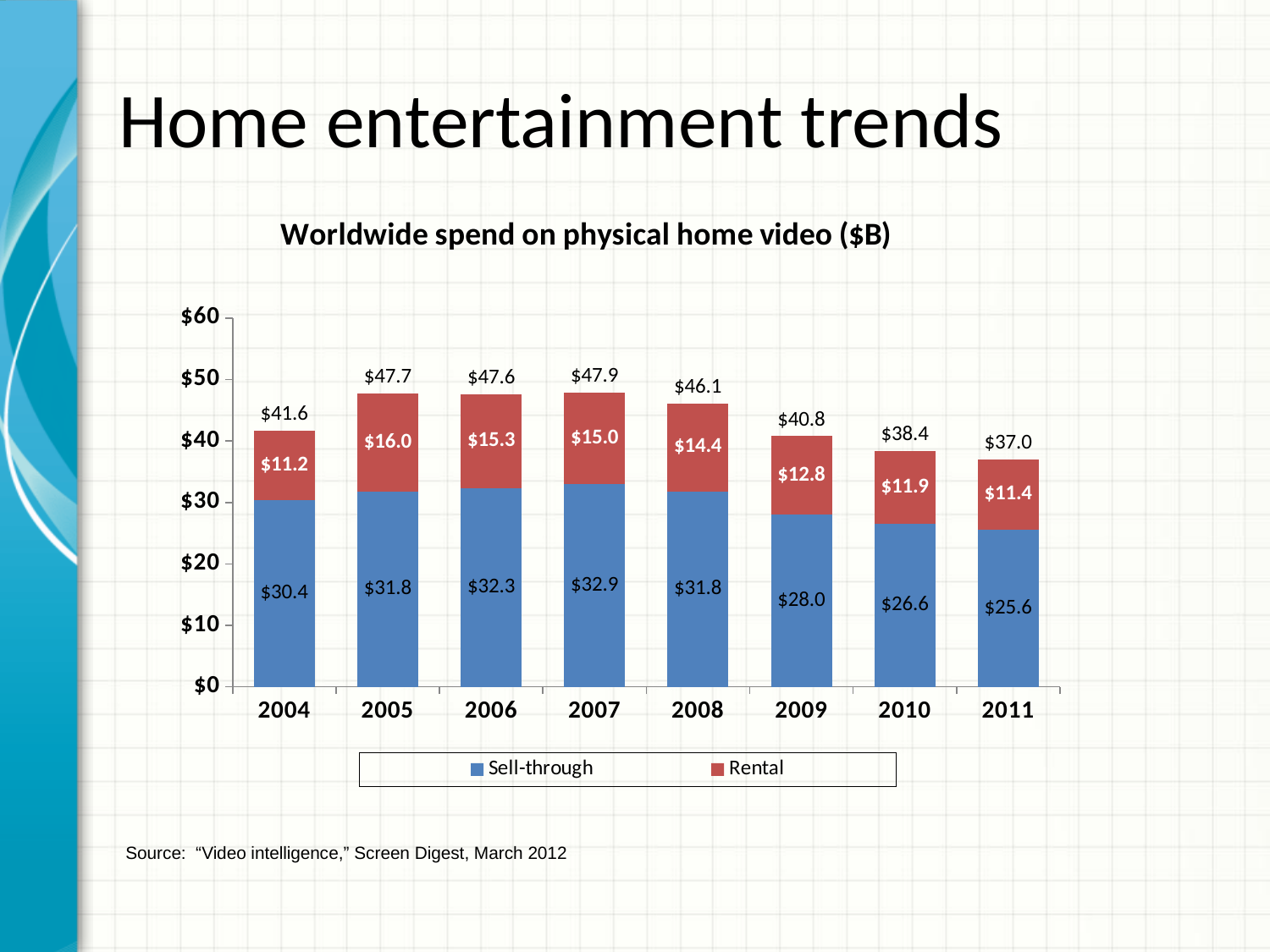
Is the total for 2009 greater or less than $40? greater What kind of chart is shown on the slide? Stacked bar chart How many series does the legend list? 2 Do the total values rise or fall from 2007 to 2011? Fall Which year has the highest total worldwide spend on physical home video? 2007 What is the difference between the Rental values for 2005 and 2011? $4.6 Which year has the lowest Rental value? 2004 What is the Sell-through value for 2007? $32.9 Which is larger, the Sell-through value for 2004 or for 2009? 2004 What is the total spend shown for 2011? $37.0 What is the Rental value for 2005? $16.0 How many years are shown on the x axis? 8